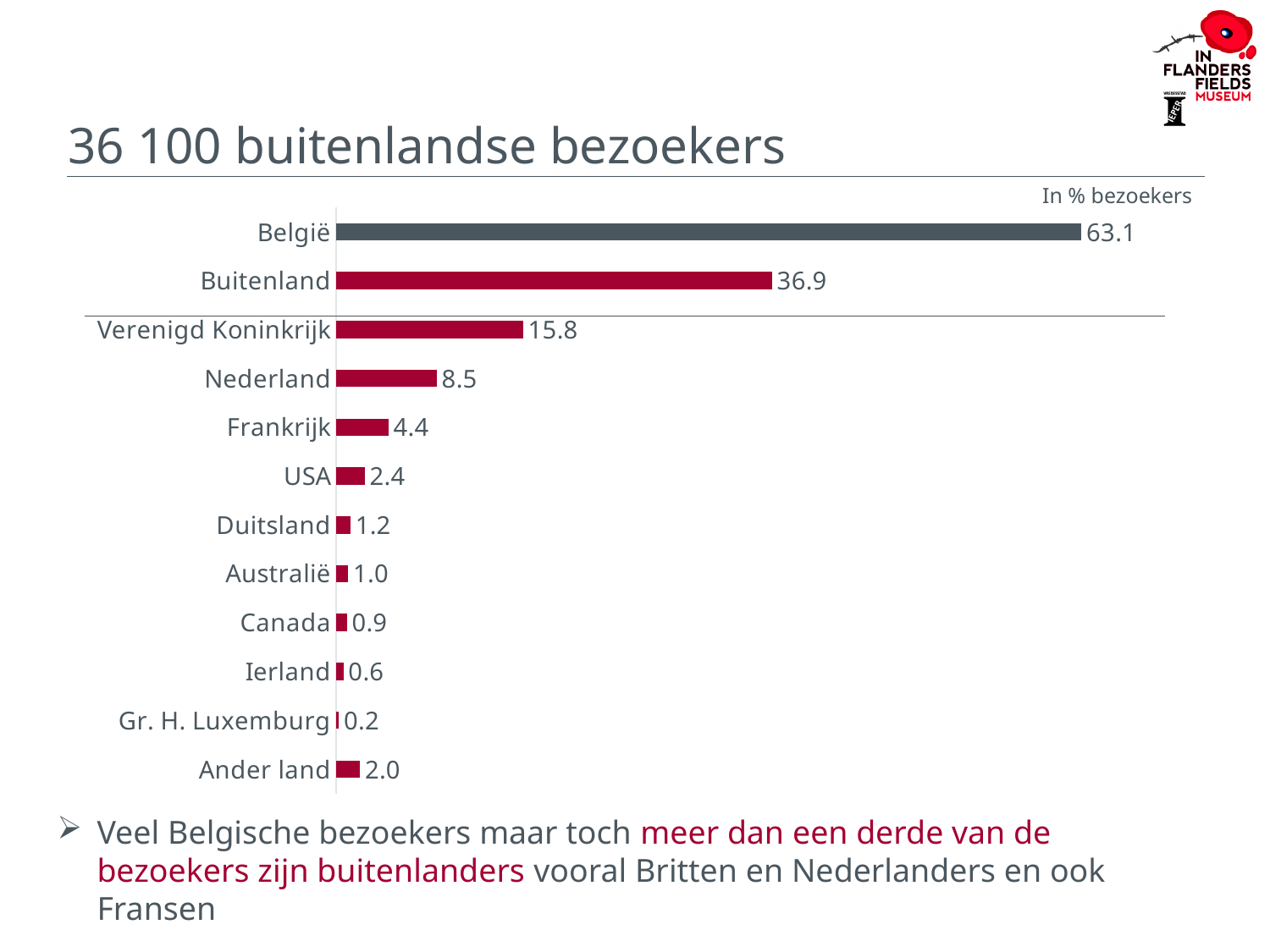
Which category has the lowest value? Gr. H. Luxemburg How many categories are shown in the chart? 12 What kind of chart is shown on the slide? Bar chart What is the value for Gr. H. Luxemburg? 0.2 What is the difference between the values for Nederland and Frankrijk? 4.1 Which category has the highest value? België What is the value for Nederland? 8.5 Which is larger, the value for USA or the value for Ander land? USA What is the difference between the values for Buitenland and Verenigd Koninkrijk? 21.1 What is the value for Verenigd Koninkrijk? 15.8 What is the value for België? 63.1 What unit does the chart say the values are in? In % bezoekers